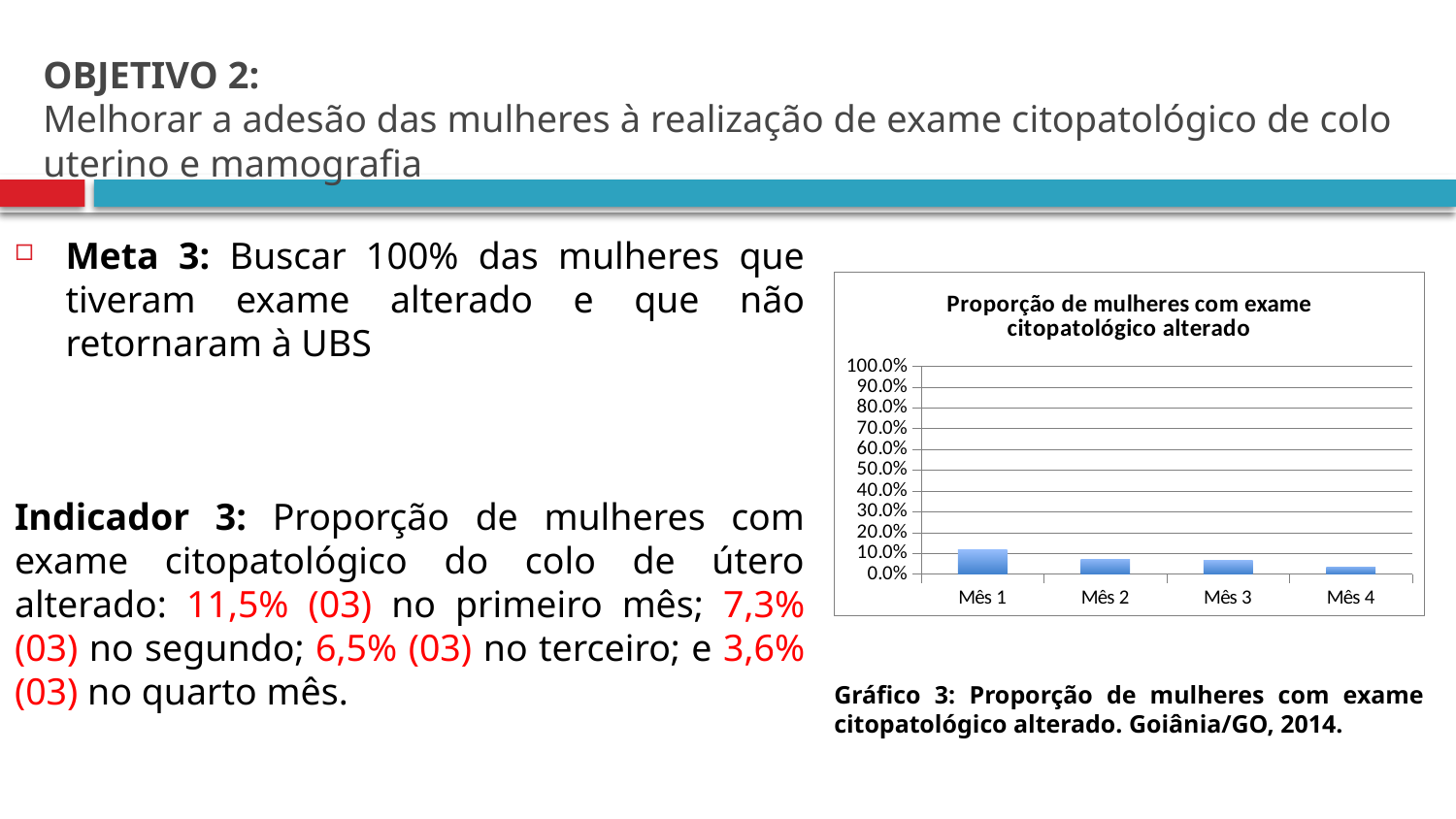
How many months (categories) are plotted on the chart? 4 Which month has the highest proportion of women with altered cytopathological exam? Mês 1 Is the value for Mês 2 greater or less than 10.0%? less Is the value for Mês 4 greater or less than 10.0%? less What kind of chart is shown on the slide? bar chart What is the highest value shown on the chart's vertical axis? 100.0% Is the value for Mês 1 greater or less than 10.0%? greater Which is larger, the value for Mês 1 or the value for Mês 4? Mês 1 What is the title of the chart? Proporção de mulheres com exame citopatológico alterado Which month has the lowest proportion of women with altered cytopathological exam? Mês 4 Do the values rise or fall from Mês 1 to Mês 4? fall